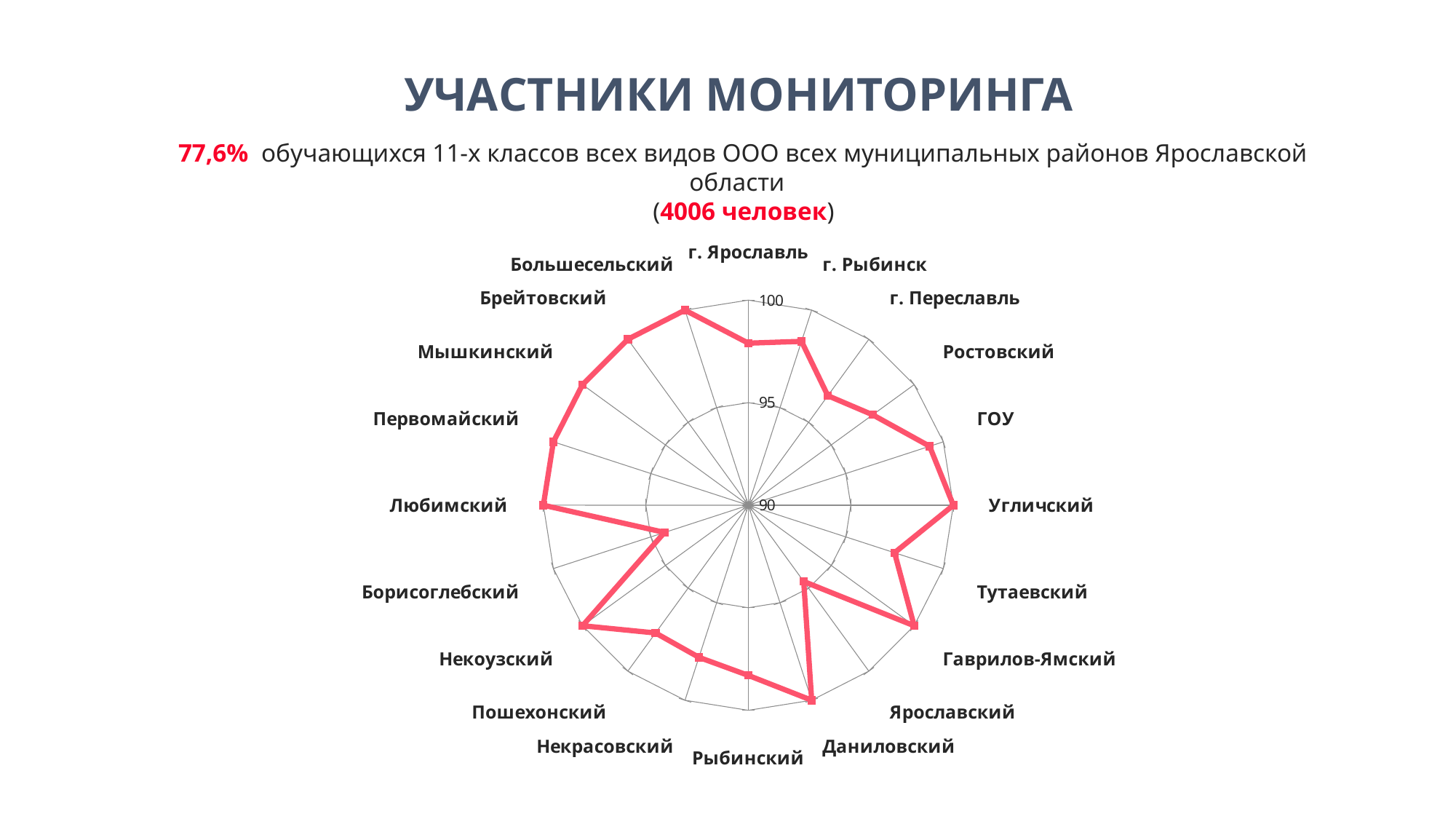
Is the value for Угличский greater or less than 95? greater Which is larger, the value for Угличский or the value for Борисоглебский? Угличский Is the value for Даниловский greater or less than 95? greater What kind of chart is shown on the slide? radar chart Is the value for Большесельский greater or less than 95? greater What is the highest tick value shown on the radar chart's axis? 100 What is the title of the slide containing the chart? УЧАСТНИКИ МОНИТОРИНГА Which is larger, the value for Любимский or the value for г. Переславль? Любимский How many categories (municipal districts) are plotted on the radar chart? 20